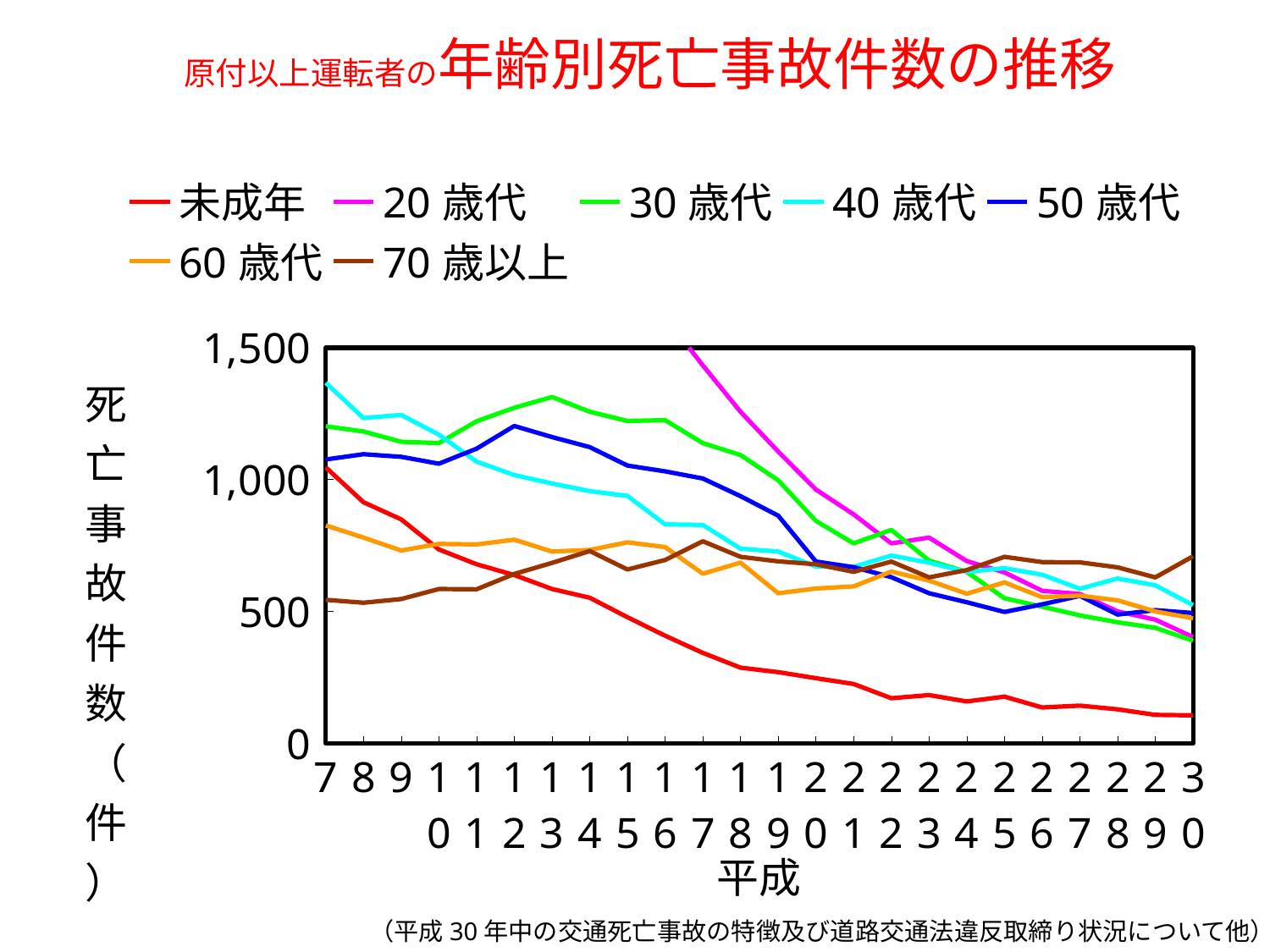
Is the value for 未成年 in 平成30 greater or less than 500? less Which series has the lowest value in 平成30? 未成年 Is the value for 70歳以上 in 平成7 greater or less than 1,000? less Does the 未成年 line rise or fall from 平成7 to 平成30? fall In 平成30, which is larger: 70歳以上 or 未成年? 70歳以上 In 平成7, which is larger: 未成年 or 70歳以上? 未成年 What is the label of the x axis? 平成 Is the value for 40歳代 in 平成7 greater or less than 1,000? greater How many years (points) are plotted along the x axis? 24 How many series does the legend list? 7 What kind of chart is shown on the slide? line chart